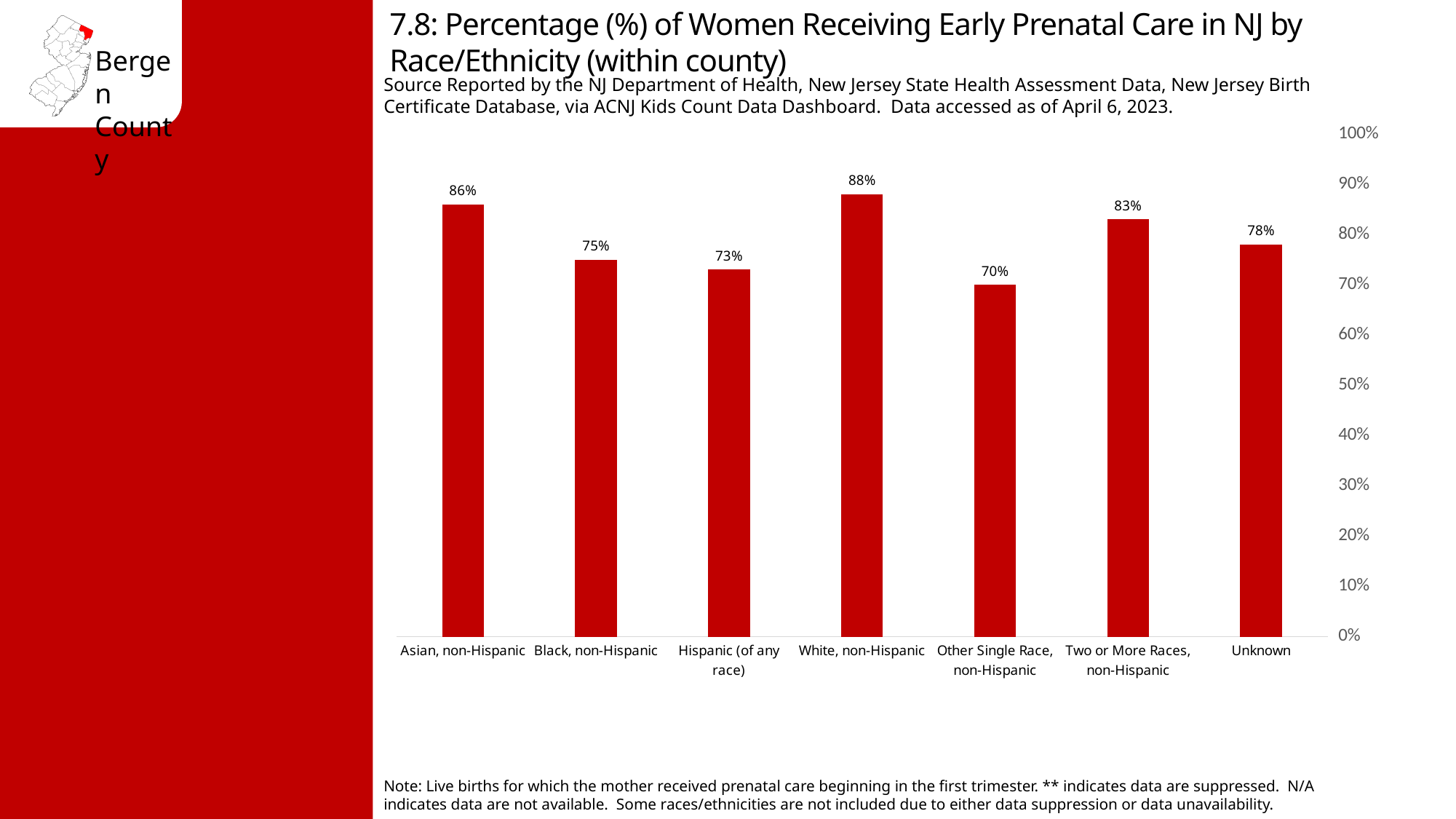
What is the value shown for Two or More Races, non-Hispanic? 83% What is the difference between the White, non-Hispanic value and the Other Single Race, non-Hispanic value? 18% Which race/ethnicity category has the lowest percentage? Other Single Race, non-Hispanic Is the value for Hispanic (of any race) greater or less than 80%? less Which is larger, the value for Unknown or the value for Black, non-Hispanic? Unknown Which race/ethnicity category has the highest percentage of women receiving early prenatal care? White, non-Hispanic What is the value shown for Black, non-Hispanic? 75% What percentage of Asian, non-Hispanic women received early prenatal care? 86% What is the highest value shown on the vertical axis? 100% How many race/ethnicity categories are shown on the chart? 7 What type of chart is shown on the slide? Bar chart What is the value shown for Hispanic (of any race)? 73%